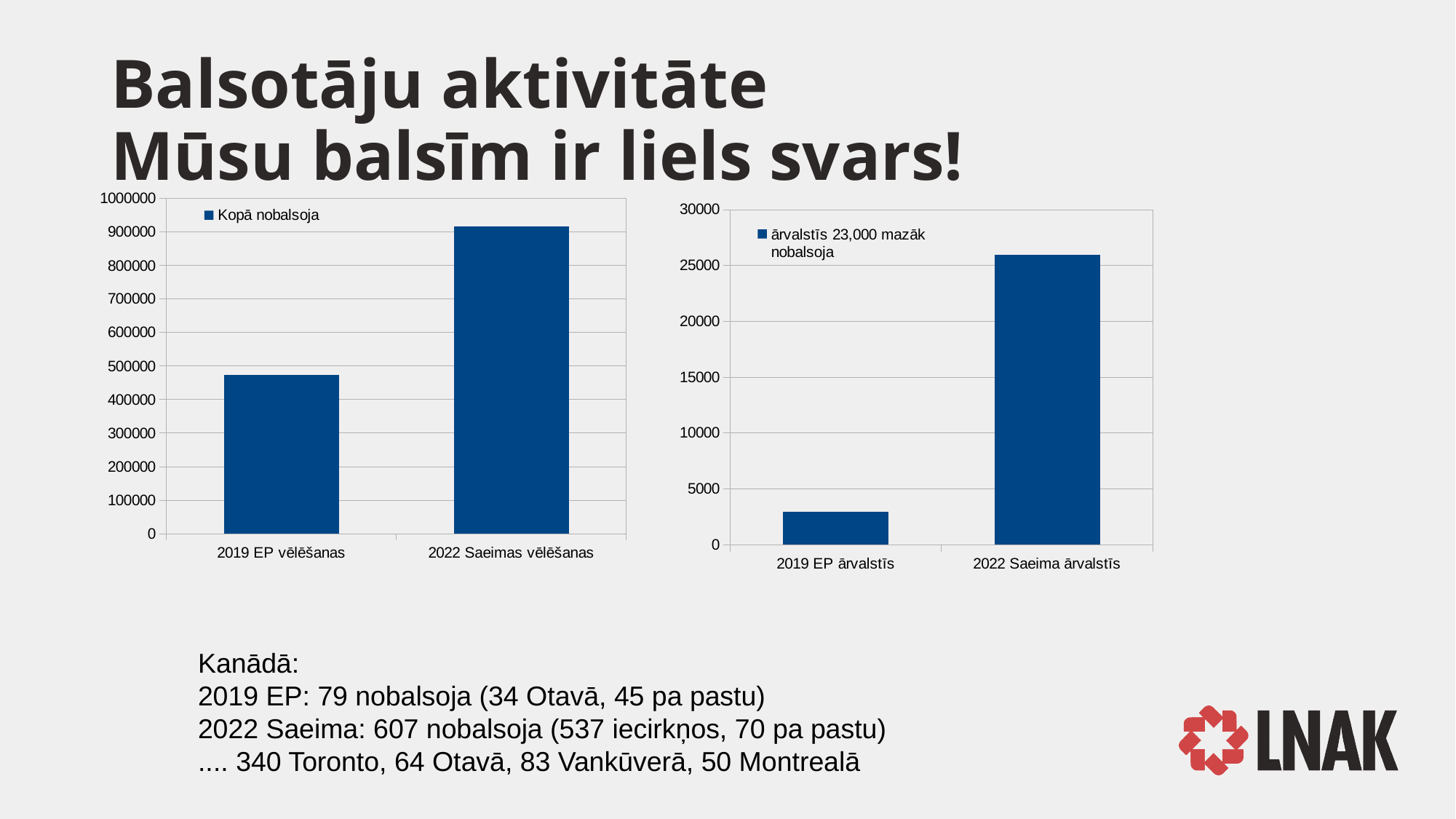
In the left chart, which category has the higher value? 2022 Saeimas vēlēšanas In the left chart, how many categories are shown on the x axis? 2 In the right chart, which category has the higher value? 2022 Saeima ārvalstīs In the right chart, do the values rise or fall from 2019 EP ārvalstīs to 2022 Saeima ārvalstīs? rise In the left chart, what series name does the legend show? Kopā nobalsoja What type of chart is the left chart? bar chart In the left chart, which category has the lower value? 2019 EP vēlēšanas In the right chart, how many series does the legend list? 1 In the right chart, is the value for 2022 Saeima ārvalstīs greater or less than 25000? greater In the left chart, is the value for 2022 Saeimas vēlēšanas greater or less than 900000? greater In the left chart, is the value for 2019 EP vēlēšanas greater or less than 500000? less